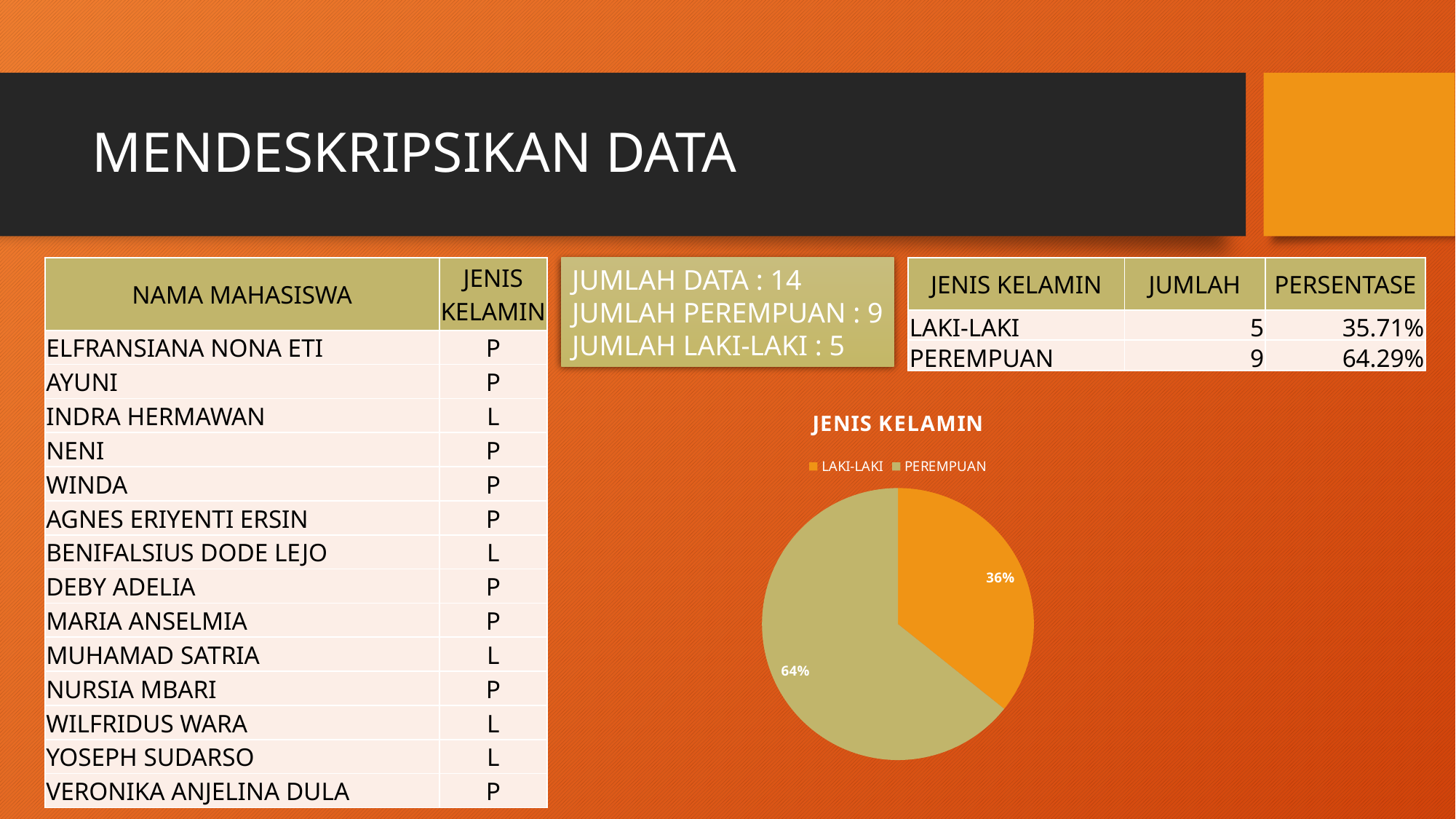
How many slices does the pie chart have? 2 What is the data label shown on the PEREMPUAN slice of the pie chart? 64% Which colour represents LAKI-LAKI in the pie chart? orange What share of the pie chart does PEREMPUAN take? 64% What kind of chart is shown on the slide? pie chart Which slice of the pie chart is the largest? PEREMPUAN In the pie chart, which is larger, LAKI-LAKI or PEREMPUAN? PEREMPUAN What is the difference in percentage points between the PEREMPUAN and LAKI-LAKI slices of the pie chart? 28% What is the title of the pie chart? JENIS KELAMIN Which slice of the pie chart is the smallest? LAKI-LAKI How many entries does the pie chart's legend list? 2 What share of the pie chart does LAKI-LAKI take? 36%